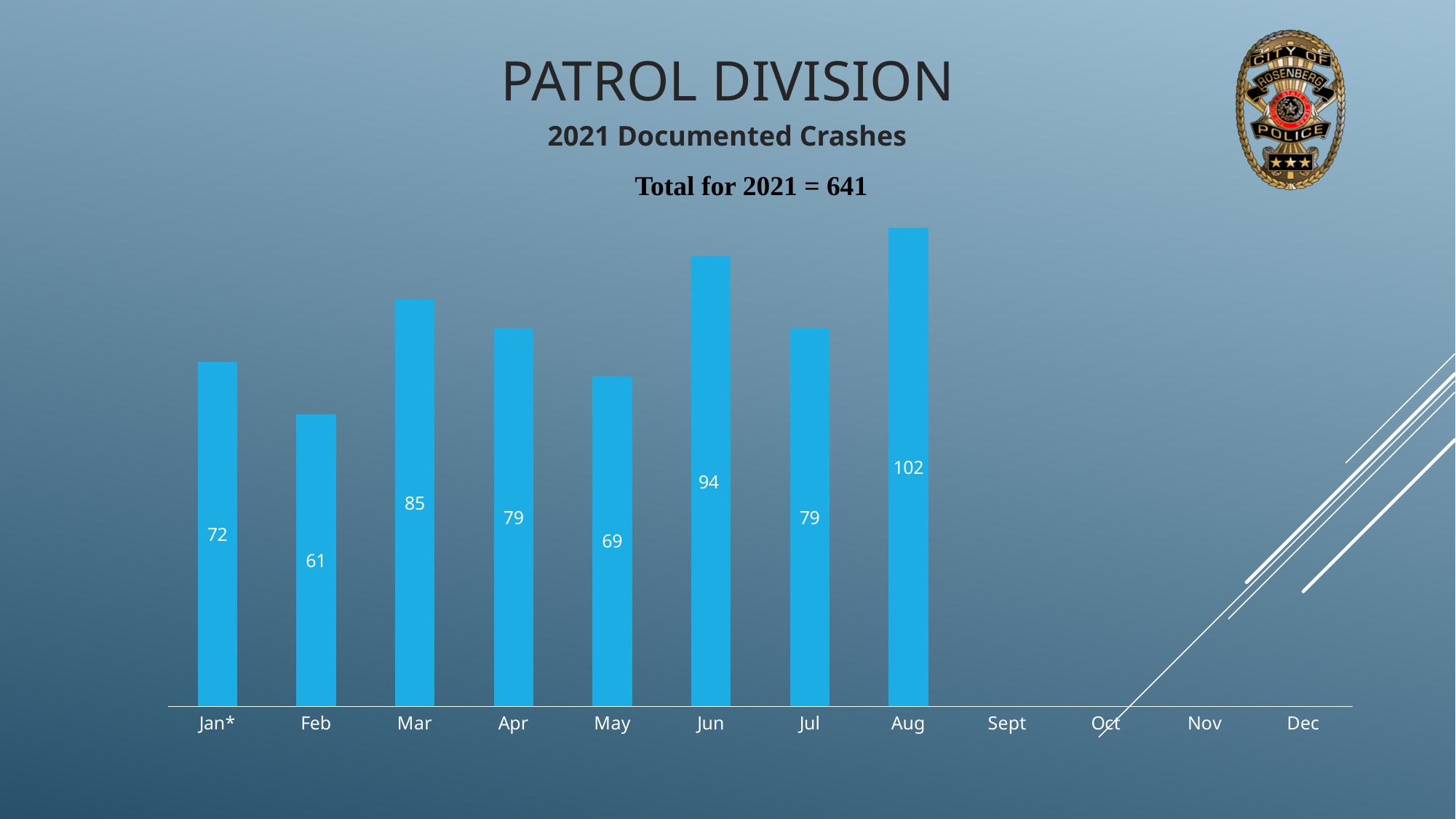
What kind of chart is shown on the slide? Bar chart What total for 2021 is stated above the chart? 641 Which month has the lowest number of documented crashes among those with data? Feb What is the number of documented crashes for Jun? 94 What is the difference between the crashes in Aug and Feb? 41 What is the number of documented crashes for Aug? 102 What is the number of documented crashes for Feb? 61 Which month has the highest number of documented crashes? Aug Which month has more documented crashes, Jun or Jul? Jun What is the difference between the crashes in Mar and May? 16 How many months have a bar with data plotted? 8 How many month labels are shown on the x axis? 12